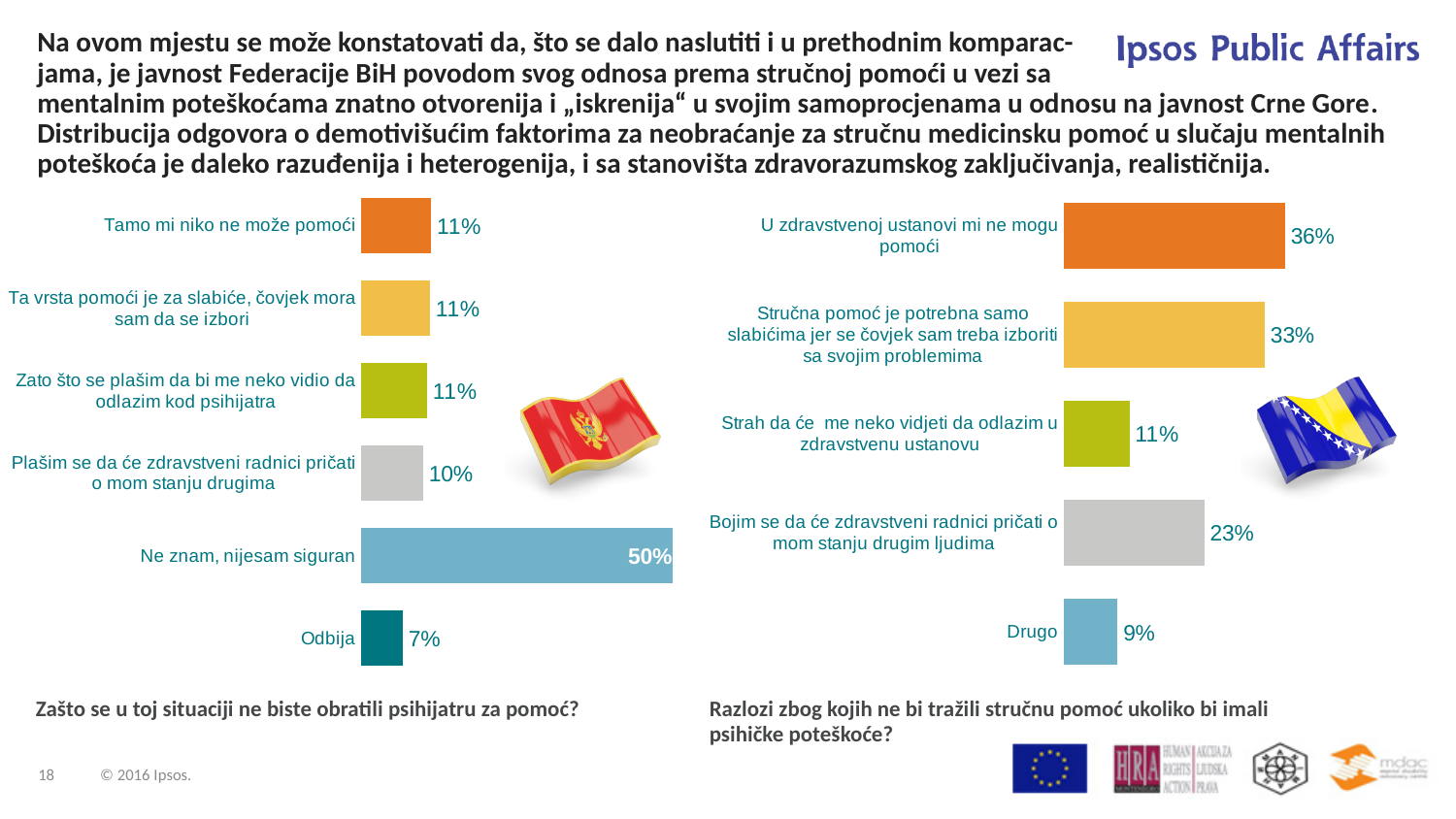
How many categories does the right chart show? 5 In the right chart, which category has the lowest value? Drugo How many categories does the left chart show? 6 In the right chart, what is the value for "Bojim se da će zdravstveni radnici pričati o mom stanju drugim ljudima"? 23% What type of chart is the right chart? Bar chart In the right chart, what is the difference between the values for "U zdravstvenoj ustanovi mi ne mogu pomoći" and "Stručna pomoć je potrebna samo slabićima jer se čovjek sam treba izboriti sa svojim problemima"? 3% In the left chart, which category has the lowest value? Odbija In the right chart, what is the value for "U zdravstvenoj ustanovi mi ne mogu pomoći"? 36% In the left chart, what is the value for "Odbija"? 7% In the left chart, what is the value for "Ne znam, nijesam siguran"? 50% In the right chart, which is larger: the value for "Bojim se da će zdravstveni radnici pričati o mom stanju drugim ljudima" or the value for "Strah da će me neko vidjeti da odlazim u zdravstvenu ustanovu"? Bojim se da će zdravstveni radnici pričati o mom stanju drugim ljudima In the left chart, which category has the highest value? Ne znam, nijesam siguran